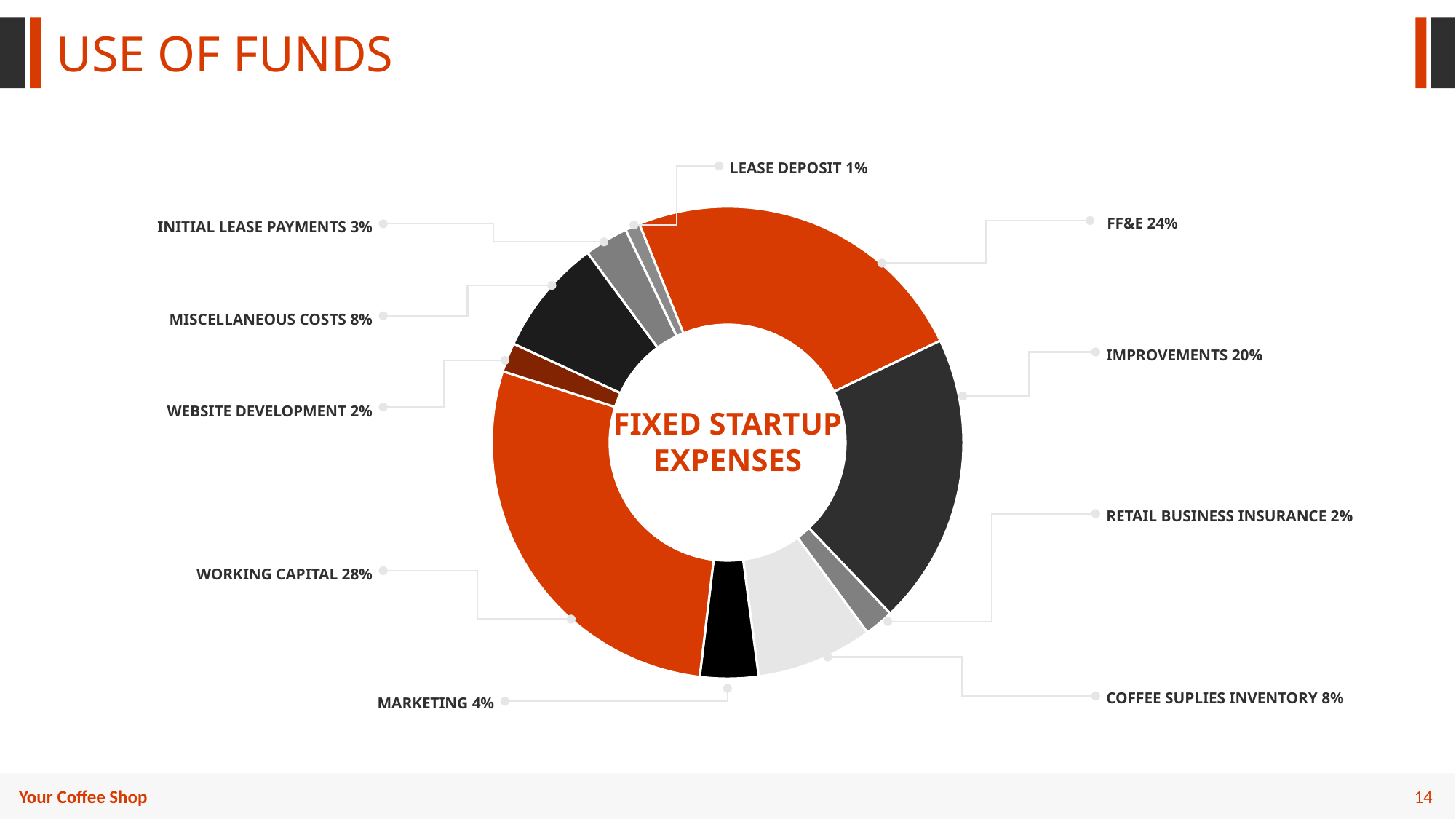
What percentage is shown for Marketing? 4% How many categories are shown in the chart? 10 What share of fixed startup expenses is Working Capital? 28% What text appears in the centre of the donut chart? FIXED STARTUP EXPENSES What percentage is shown for Improvements? 20% What is the combined share of Coffee Suplies Inventory and Miscellaneous Costs? 16% Which category has the smallest share of the chart? Lease Deposit What percentage is shown for FF&E? 24% Which category has the largest share of the chart? Working Capital What is the difference in percentage points between Working Capital and FF&E? 4 Which is larger, Improvements or Miscellaneous Costs? Improvements What kind of chart is shown on the slide? Pie chart (donut)